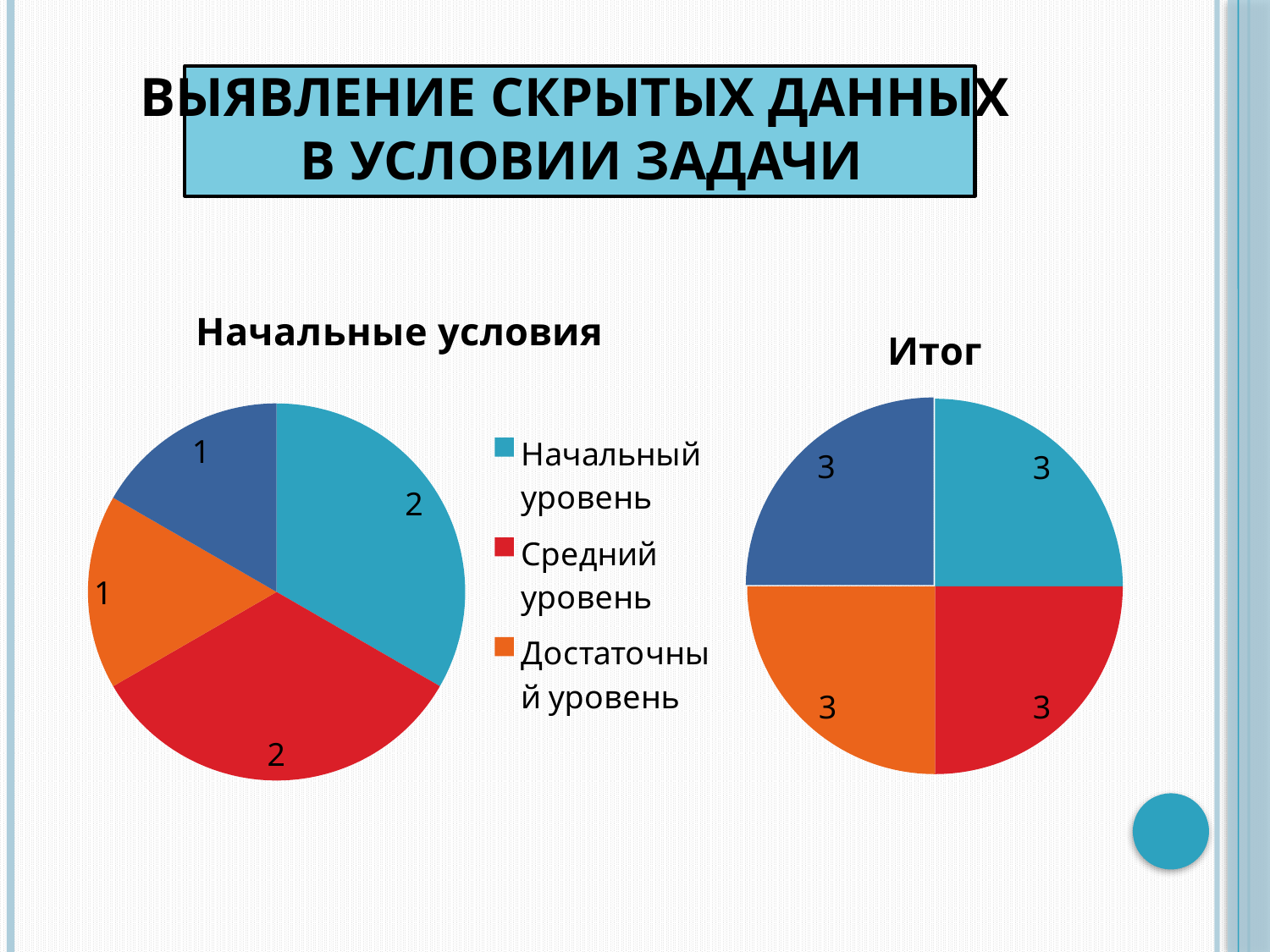
In the 'Итог' chart, what is the value for Средний уровень? 3 In the 'Начальные условия' chart, which is larger, Начальный уровень or Достаточный уровень? Начальный уровень In the 'Начальные условия' chart, what is the value for Начальный уровень? 2 How many slices does the 'Итог' pie chart have? 4 In the 'Начальные условия' chart, what is the value for Средний уровень? 2 What is the title of the chart on the right of the slide? Итог What kind of chart is the 'Начальные условия' chart? pie chart In the 'Начальные условия' chart, what is the value for Достаточный уровень? 1 In the 'Итог' chart, what share of the pie does Начальный уровень represent? 25% What is the total of all slice values in the 'Итог' chart? 12 How many entries does the legend between the two charts list? 3 In the 'Начальные условия' chart, what is the difference between Средний уровень and Достаточный уровень? 1